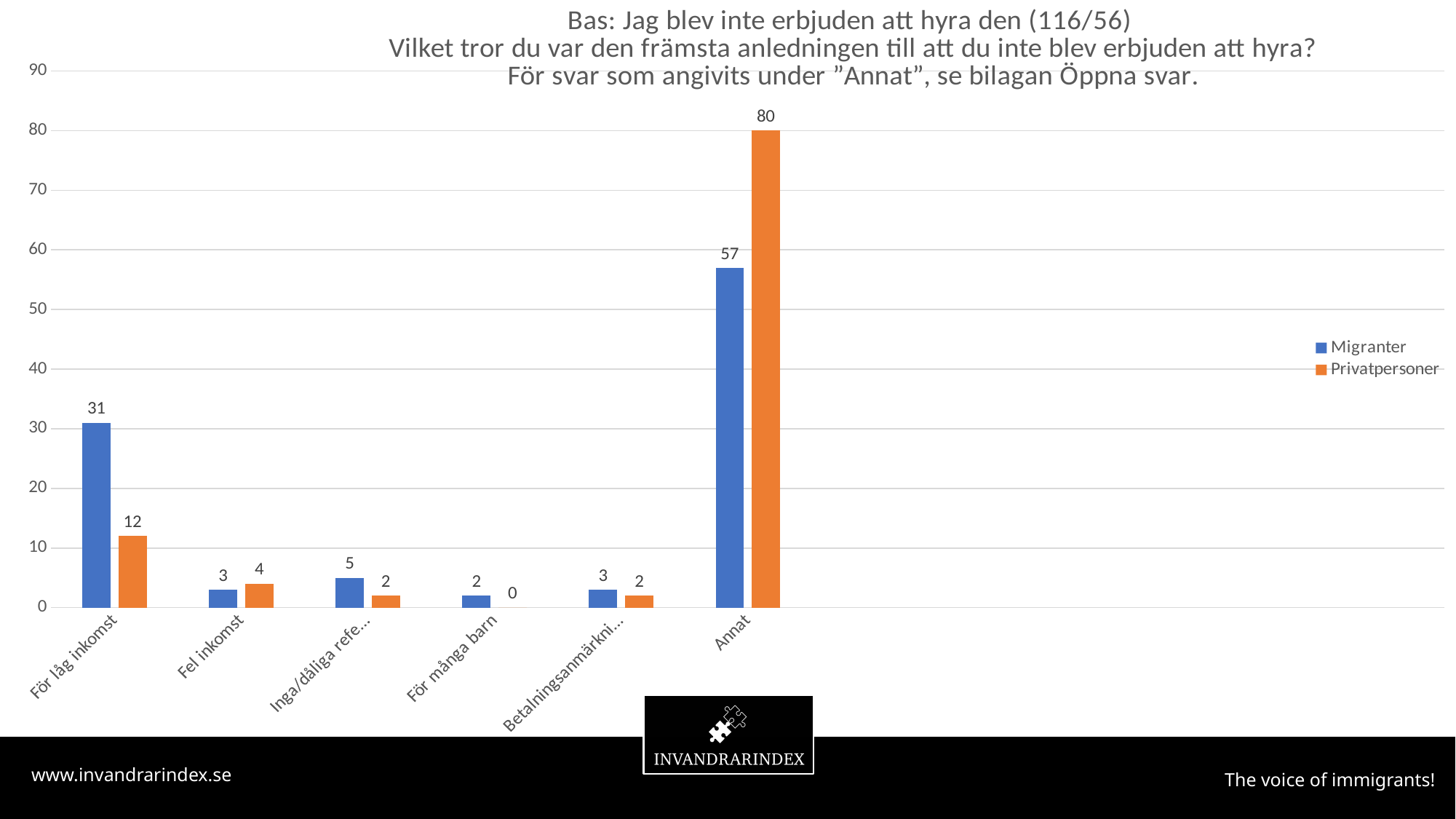
In the 'Fel inkomst' category, which series has the larger value, Migranter or Privatpersoner? Privatpersoner What is the difference between the Migranter and Privatpersoner values in the 'För låg inkomst' category? 19 What is the difference between the Privatpersoner and Migranter values in the 'Annat' category? 23 How many series does the legend list? 2 Which colour represents the Privatpersoner series? Orange What is the value for Privatpersoner in the 'För många barn' category? 0 What is the value for Privatpersoner in the 'Annat' category? 80 Which category has the highest value for Migranter? Annat How many categories are shown on the x axis? 6 What is the value for Migranter in the 'För låg inkomst' category? 31 Which category has the lowest value for Privatpersoner? För många barn What kind of chart is shown on the slide? Bar chart